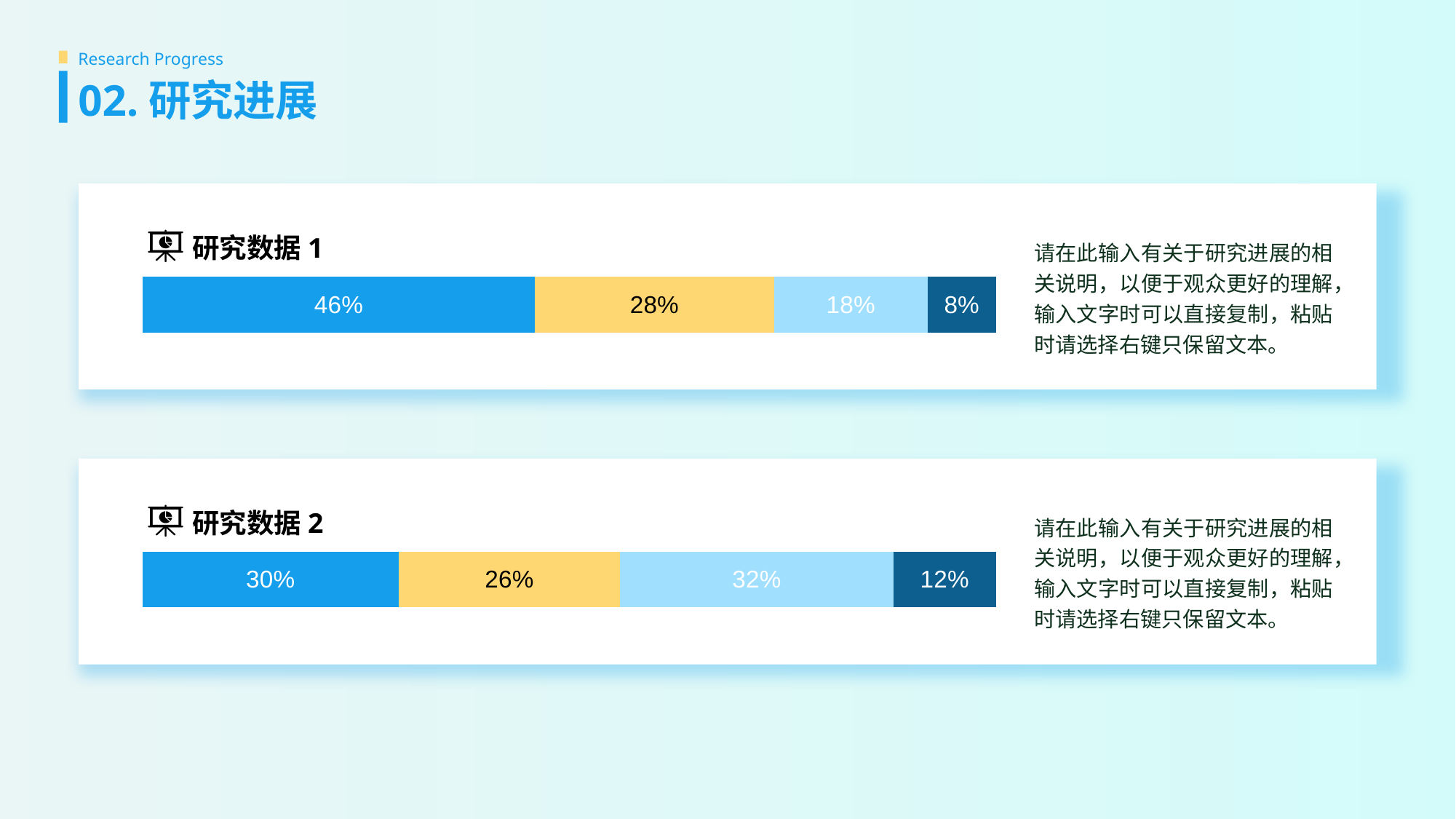
In the 研究数据 1 chart, what is the value of the yellow segment? 28% Which is larger: the yellow segment in 研究数据 1 or the yellow segment in 研究数据 2? 研究数据 1 (28%) In the 研究数据 1 chart, what is the value of the last (rightmost, dark blue) segment? 8% In the 研究数据 1 chart, what is the value of the first (leftmost) segment? 46% What type of chart is used for 研究数据 1 and 研究数据 2? Stacked horizontal bar chart What is the total of all segments in the 研究数据 1 bar? 100% In the 研究数据 2 chart, which segment has the smallest value? The last (rightmost, dark blue) segment, 12% How many segments does the 研究数据 2 bar contain? 4 In the 研究数据 1 chart, what is the difference between the first segment (46%) and the yellow segment (28%)? 18% In the 研究数据 2 chart, what is the value of the light blue (third) segment? 32% In the 研究数据 1 chart, which segment has the largest value? The first (leftmost, blue) segment, 46% In the 研究数据 2 chart, what is the value of the dark blue (rightmost) segment? 12%